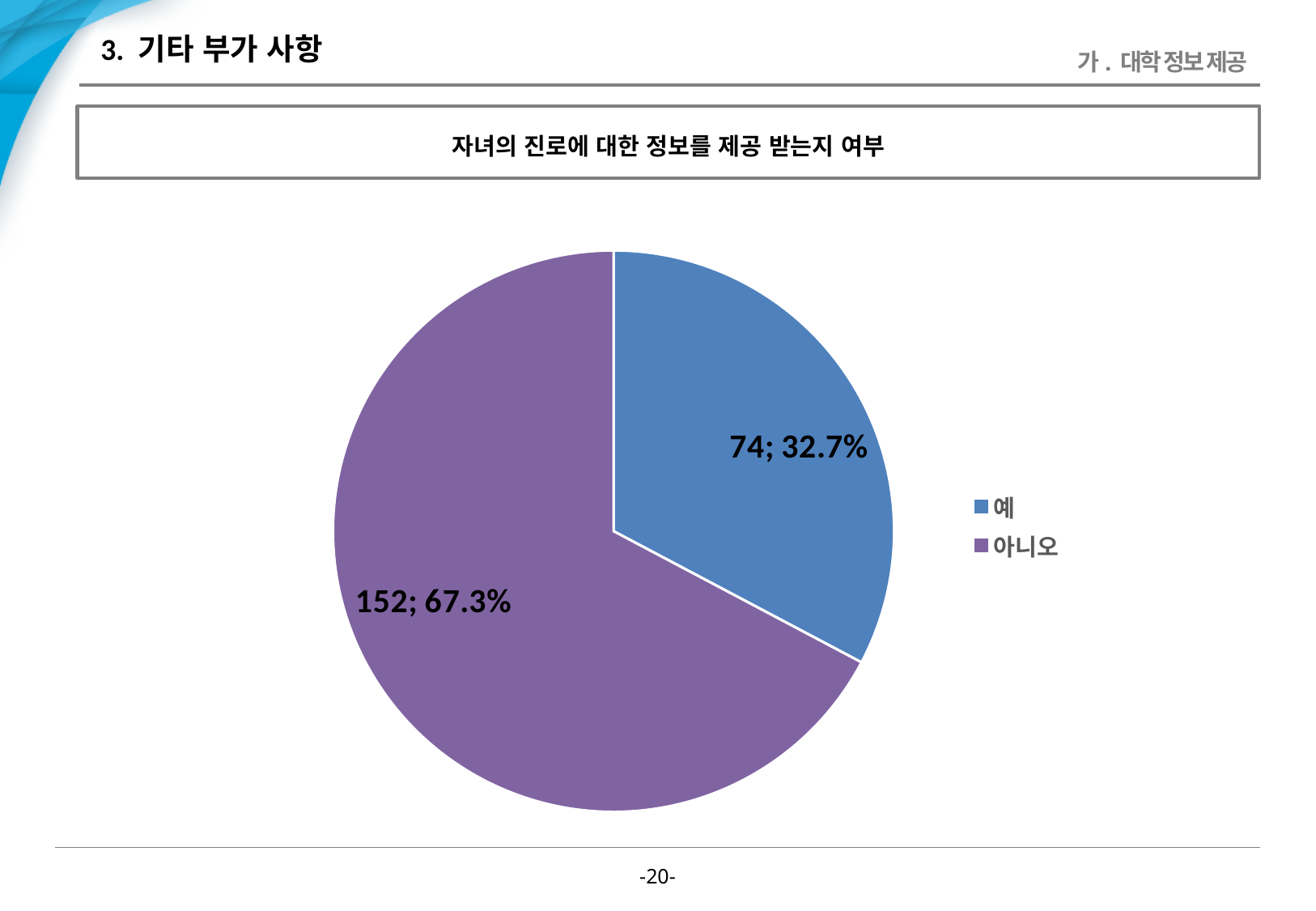
What is the total count across both slices? 226 Which category has the smallest slice? 예 What share of the pie does 예 represent? 32.7% What kind of chart is shown on the slide? pie chart How many entries does the legend list? 2 Which is larger, the count for 예 or the count for 아니오? 아니오 How many slices does the pie chart have? 2 What is the difference in count between 아니오 and 예? 78 What is the count for 예? 74 What share of the pie does 아니오 represent? 67.3% Which category has the largest slice? 아니오 What is the count for 아니오? 152